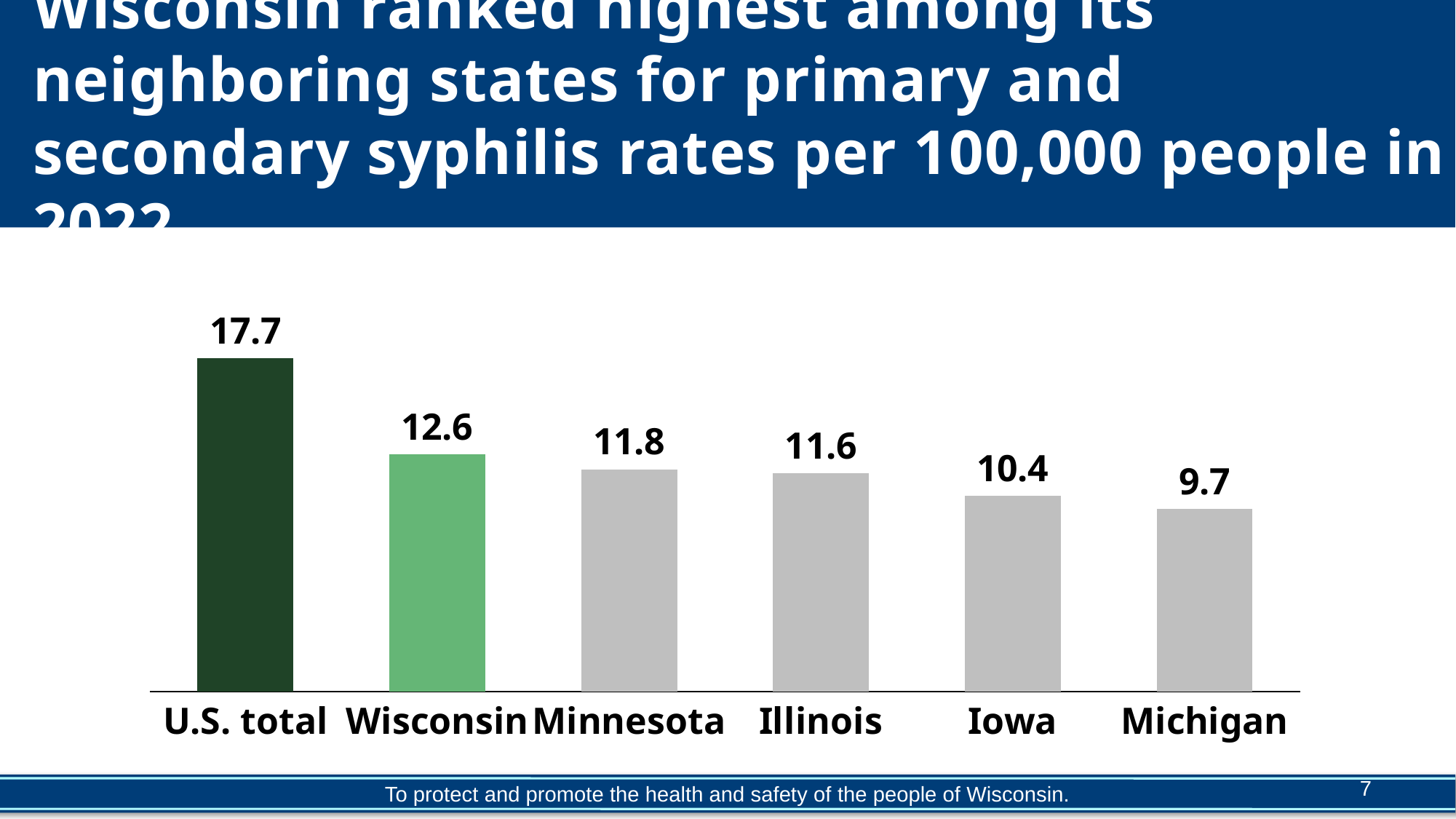
Which is larger, the value for Wisconsin or the value for Minnesota? Wisconsin What kind of chart is shown on the slide? Bar chart How many categories are shown in the chart? 6 What is the difference between the values for U.S. total and Wisconsin? 5.1 What is the value for Iowa? 10.4 Which bar is coloured light green? Wisconsin What is the difference between the values for Minnesota and Illinois? 0.2 What is the value for U.S. total? 17.7 What is the value for Michigan? 9.7 What is the value for Wisconsin? 12.6 Which category has the lowest value? Michigan Which category has the highest value? U.S. total